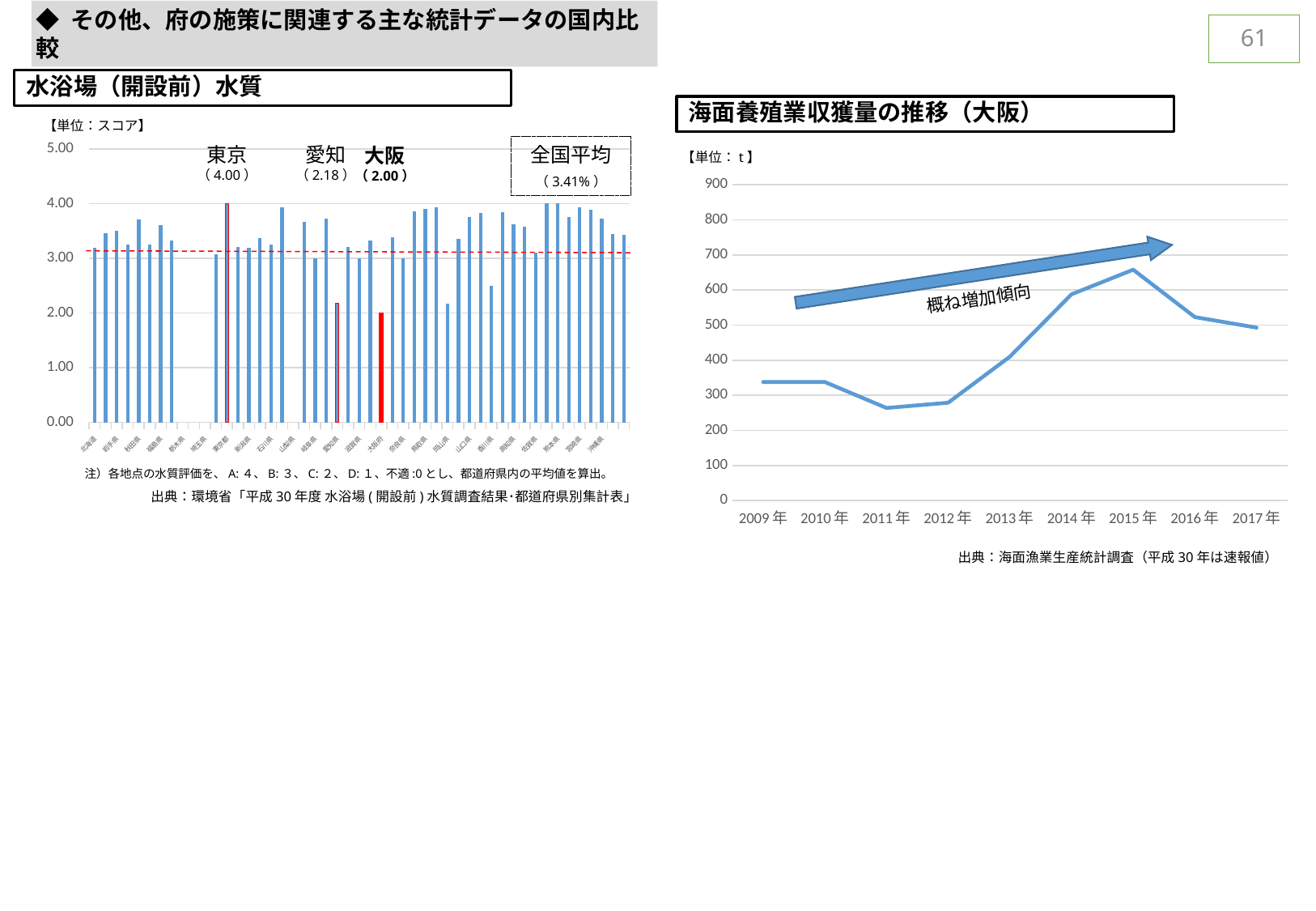
In the 海面養殖業収獲量の推移（大阪） chart, which year has the highest value? 2015年 In the 海面養殖業収獲量の推移（大阪） chart, how many years are plotted on the x axis? 9 In the 水浴場（開設前）水質 chart, what is the 全国平均 value shown? 3.41% What kind of chart is the 水浴場（開設前）水質 chart? Bar chart In the 水浴場（開設前）水質 chart, which is larger, the value for 東京 or the value for 愛知? 東京 In the 水浴場（開設前）水質 chart, what is the value for 東京? 4.00 In the 海面養殖業収獲量の推移（大阪） chart, is the value for 2011年 greater or less than 300? less In the 水浴場（開設前）水質 chart, what is the value for 大阪? 2.00 In the 水浴場（開設前）水質 chart, what is the value for 愛知? 2.18 What kind of chart is the 海面養殖業収獲量の推移（大阪） chart? Line chart In the 海面養殖業収獲量の推移（大阪） chart, what unit is shown for the values? t In the 水浴場（開設前）水質 chart, what is the difference between the values for 東京 and 大阪? 2.00